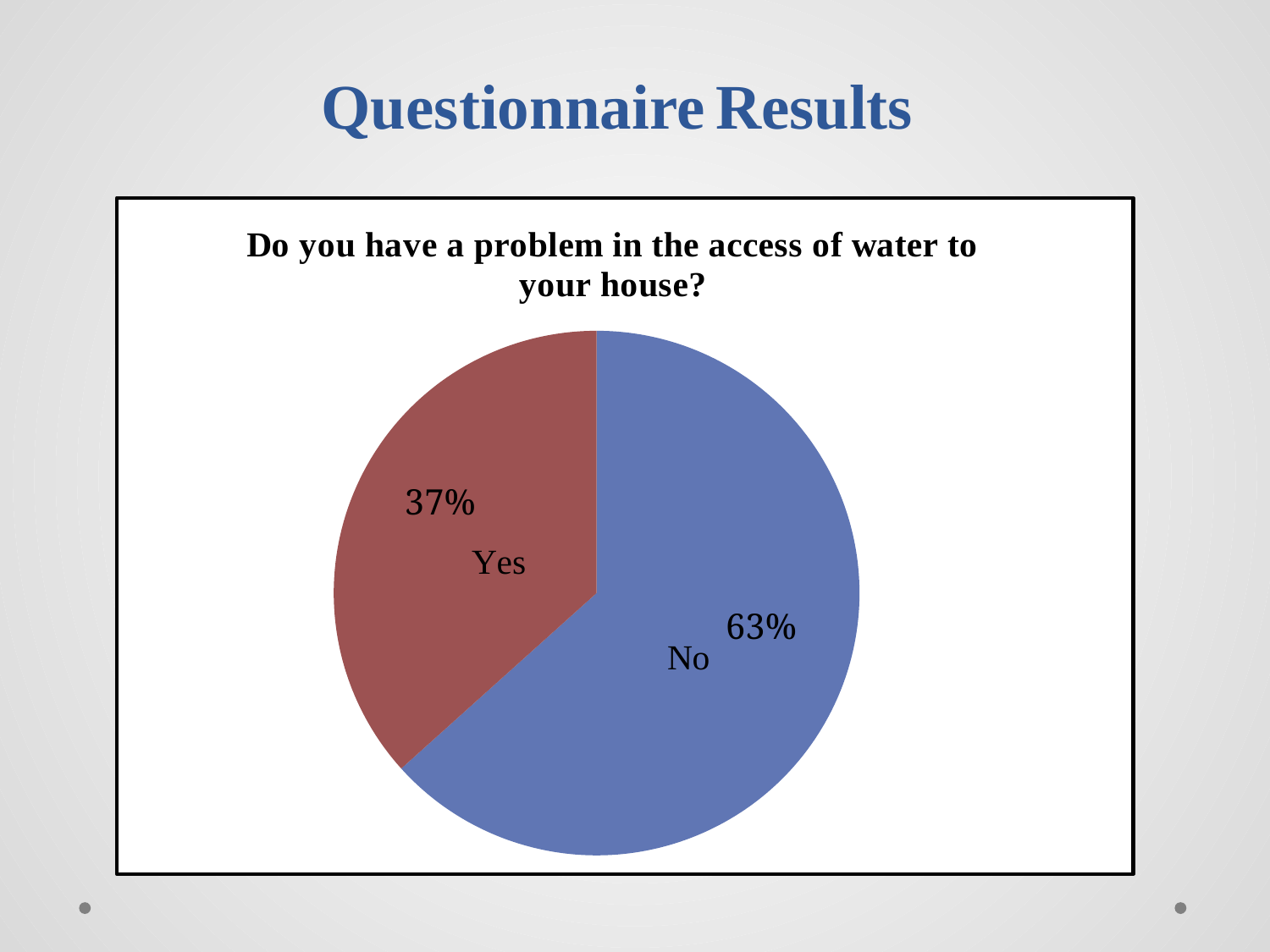
Which response has the largest share of the pie? No What percentage of respondents answered "No"? 63% Which response has the smallest share of the pie? Yes What is the chart's title? Do you have a problem in the access of water to your house? What is the difference in percentage points between the "No" and "Yes" shares? 26 How many slices does the pie chart have? 2 Which is larger, the share for "Yes" or the share for "No"? No What kind of chart is shown on the slide? pie chart What share of the pie does the "No" slice represent? 63% What percentage of respondents answered "Yes"? 37% What colour is the "Yes" slice? red